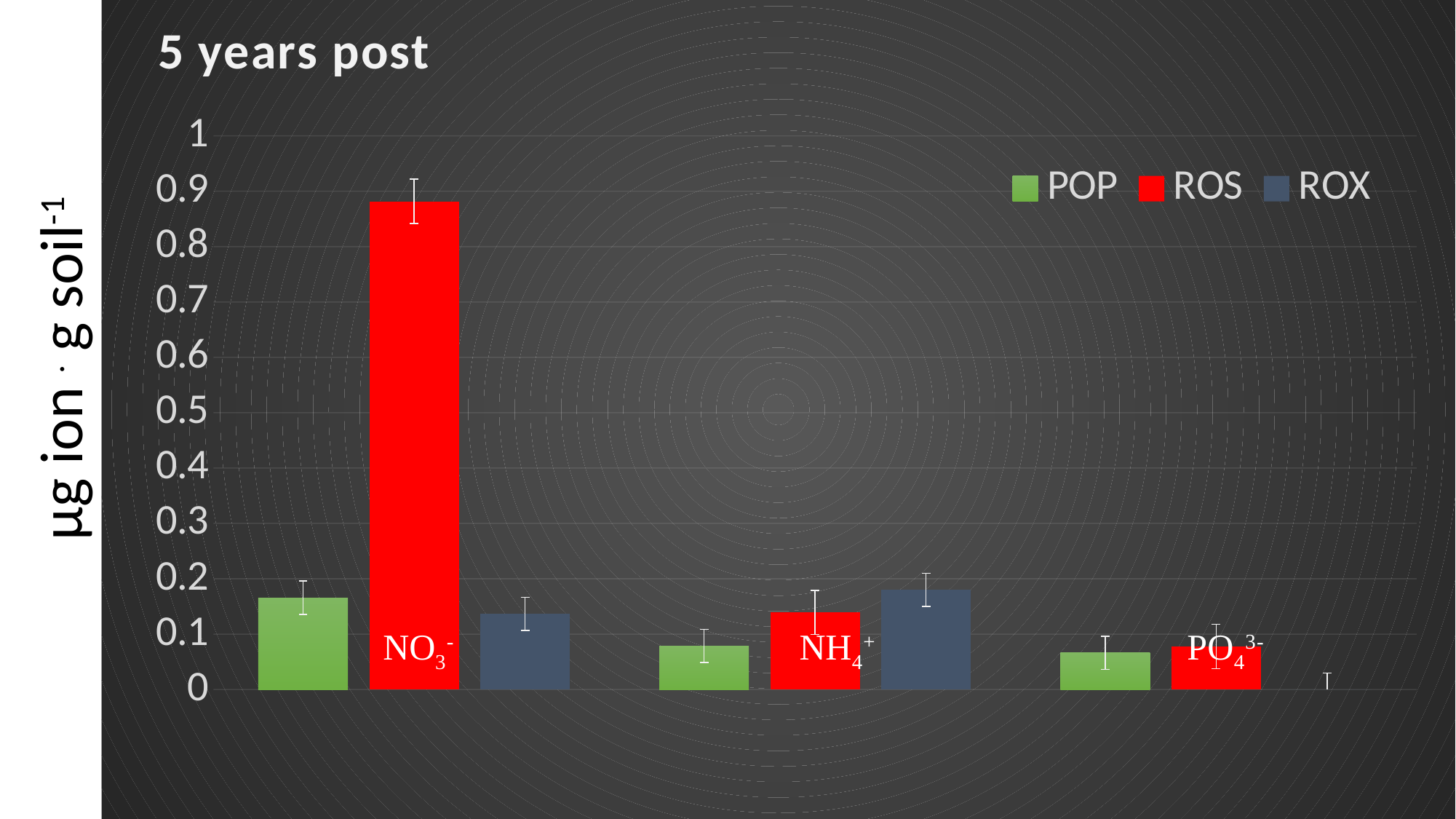
Is the POP value for NO3- greater or less than 0.2? less Is the POP value for PO4 3- greater or less than 0.1? less Which series has the lowest value for PO4 3-? ROX Which series has the highest value for NO3-? ROS Which series has the highest value for NH4+? ROX How many series does the legend list? 3 What is the title of the chart? 5 years post For NH4+, which is larger: the POP value or the ROX value? ROX What kind of chart is shown on the slide? bar chart Is the ROS value for NO3- greater or less than 0.8? greater How many ion categories are plotted along the x axis? 3